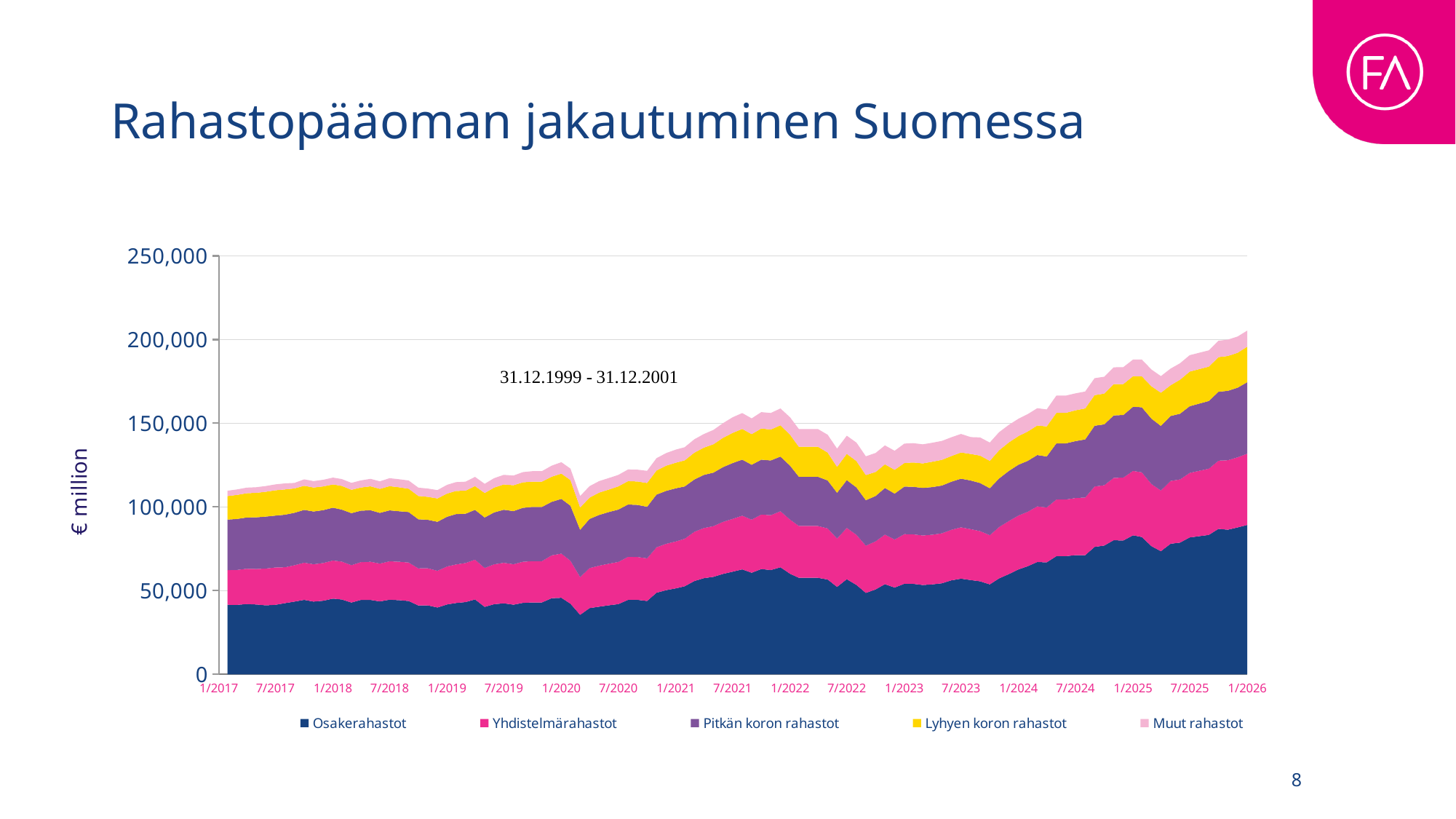
How many series does the legend list? 5 Which series has the largest value at 1/2026? Osakerahastot How many date labels are shown along the x axis? 19 Is the total value at 1/2020 greater or less than 150,000? less Is the value for Osakerahastot at 1/2017 greater or less than 50,000? less What is the label on the vertical axis? € million What kind of chart is shown on the slide? Stacked area chart What is the title of the chart? Rahastopääoman jakautuminen Suomessa Is the total value at 1/2017 greater or less than 150,000? less At 1/2026, which is larger: Osakerahastot or Muut rahastot? Osakerahastot Does the total fund capital generally rise or fall from 1/2017 to 1/2026? Rise